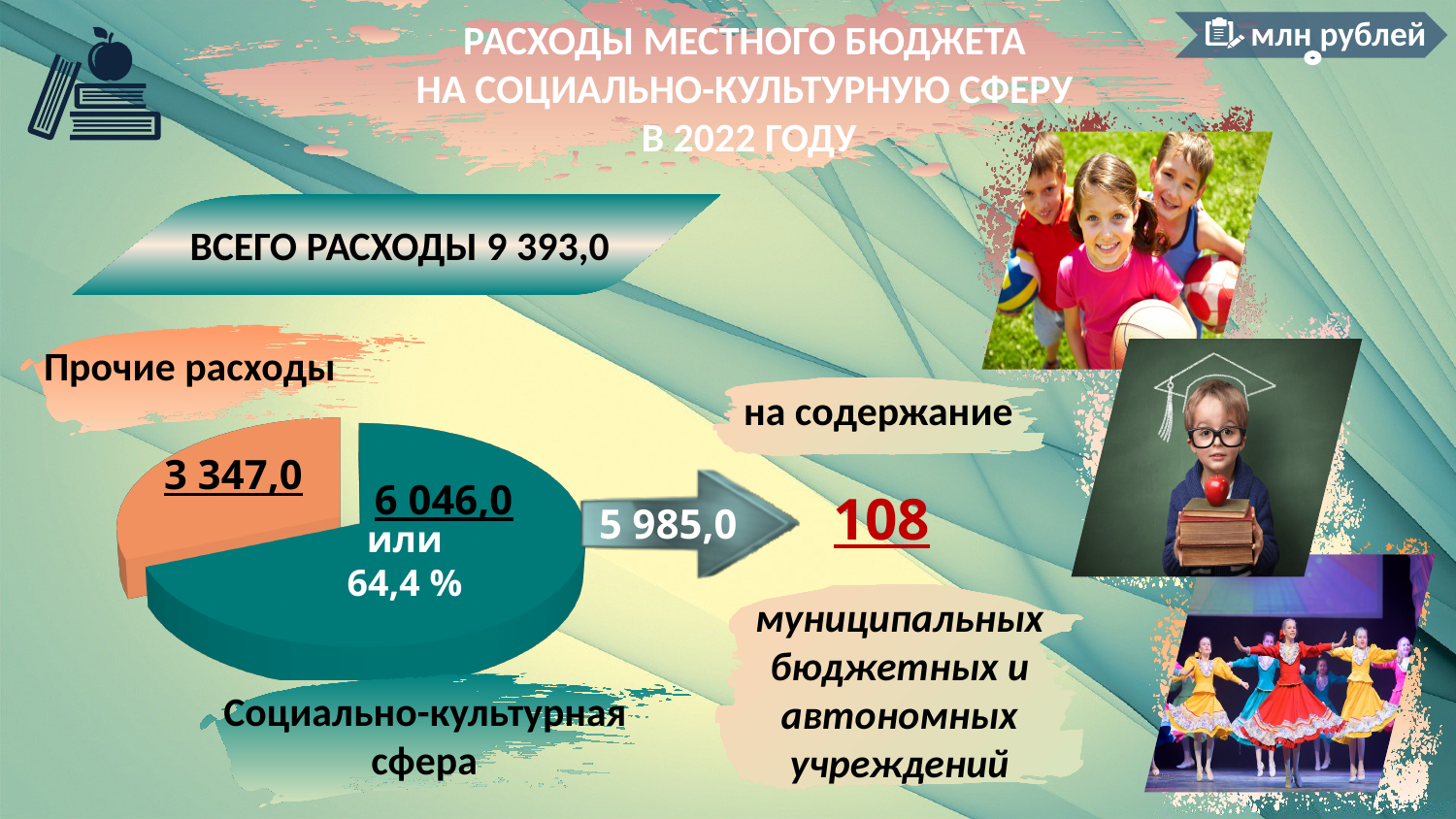
What is the difference between the values for Социально-культурная сфера and Прочие расходы? 2 699,0 What share of the pie does Социально-культурная сфера represent, as printed on the slide? 64,4 % What is the total of the two slices in the pie chart? 9 393,0 What is the value for Социально-культурная сфера in the pie chart? 6 046,0 What is the value for Прочие расходы in the pie chart? 3 347,0 Which slice of the pie chart is the smallest? Прочие расходы In what units are the values on the slide expressed? млн рублей How many slices does the pie chart have? 2 What kind of chart is shown on the slide? Pie chart Which slice of the pie chart is the largest? Социально-культурная сфера Which is larger in the pie chart: Прочие расходы or Социально-культурная сфера? Социально-культурная сфера What colour is the Социально-культурная сфера slice of the pie chart? Teal